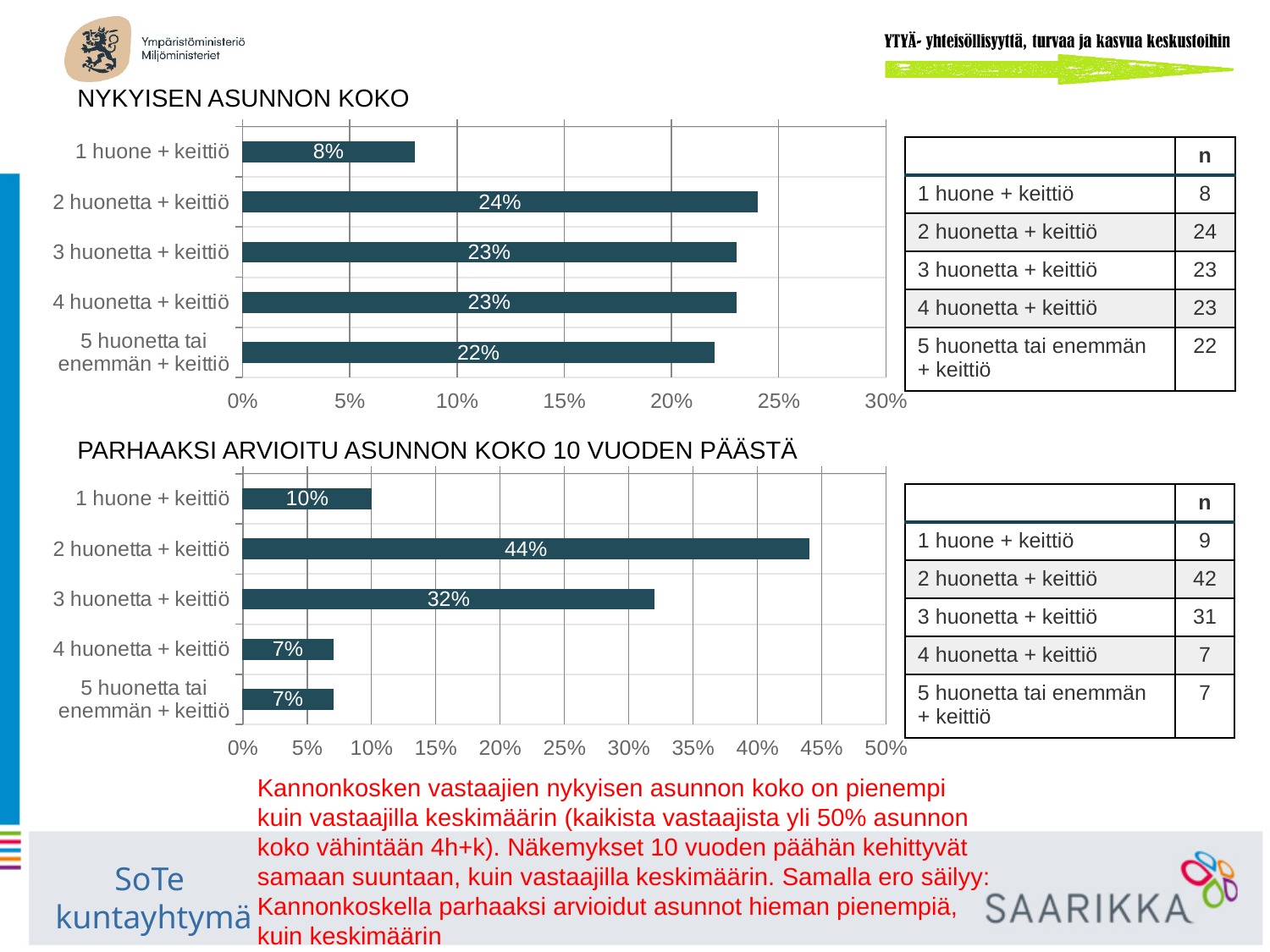
In the chart titled NYKYISEN ASUNNON KOKO, what is the difference between the values for 2 huonetta + keittiö and 5 huonetta tai enemmän + keittiö? 2% In the chart titled PARHAAKSI ARVIOITU ASUNNON KOKO 10 VUODEN PÄÄSTÄ, what is the value for 2 huonetta + keittiö? 44% In the chart titled NYKYISEN ASUNNON KOKO, what is the highest value shown on the x axis? 30% In the chart titled NYKYISEN ASUNNON KOKO, what is the value for 1 huone + keittiö? 8% In the chart titled PARHAAKSI ARVIOITU ASUNNON KOKO 10 VUODEN PÄÄSTÄ, which category has the highest value? 2 huonetta + keittiö In the chart titled PARHAAKSI ARVIOITU ASUNNON KOKO 10 VUODEN PÄÄSTÄ, which is larger: the value for 1 huone + keittiö or the value for 4 huonetta + keittiö? 1 huone + keittiö In the chart titled NYKYISEN ASUNNON KOKO, how many categories are shown? 5 In the chart titled NYKYISEN ASUNNON KOKO, what is the value for 2 huonetta + keittiö? 24% In the chart titled PARHAAKSI ARVIOITU ASUNNON KOKO 10 VUODEN PÄÄSTÄ, what is the difference between the values for 2 huonetta + keittiö and 3 huonetta + keittiö? 12% In the chart titled NYKYISEN ASUNNON KOKO, which category has the lowest value? 1 huone + keittiö What kind of chart is the chart titled PARHAAKSI ARVIOITU ASUNNON KOKO 10 VUODEN PÄÄSTÄ? Bar chart In the chart titled PARHAAKSI ARVIOITU ASUNNON KOKO 10 VUODEN PÄÄSTÄ, what is the value for 3 huonetta + keittiö? 32%